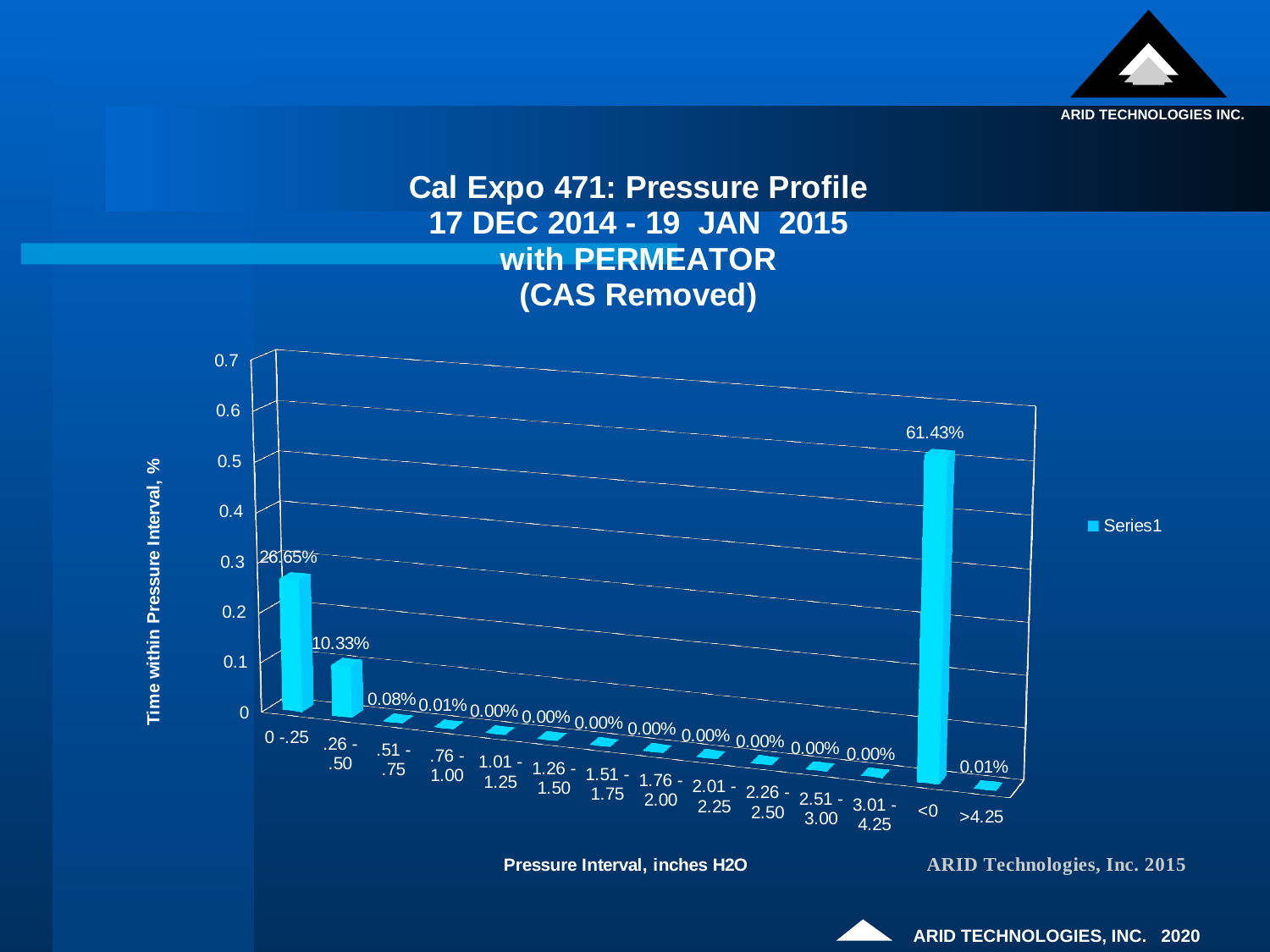
What is the value for the .51 - .75 pressure interval? 0.08% What is the value for the <0 pressure interval? 61.43% Which pressure interval has the highest value? <0 How many pressure intervals are shown on the x axis? 14 What kind of chart is shown on the slide? Bar chart What is the value for the .26 - .50 pressure interval? 10.33% What is the value for the 0 -.25 pressure interval? 26.65% What is the difference between the values for the <0 and 0 -.25 intervals? 34.78% What is the difference between the values for the 0 -.25 and .26 - .50 intervals? 16.32% How many series does the legend list? 1 Which is larger, the value for 0 -.25 or the value for .26 - .50? 0 -.25 What is the value for the >4.25 pressure interval? 0.01%